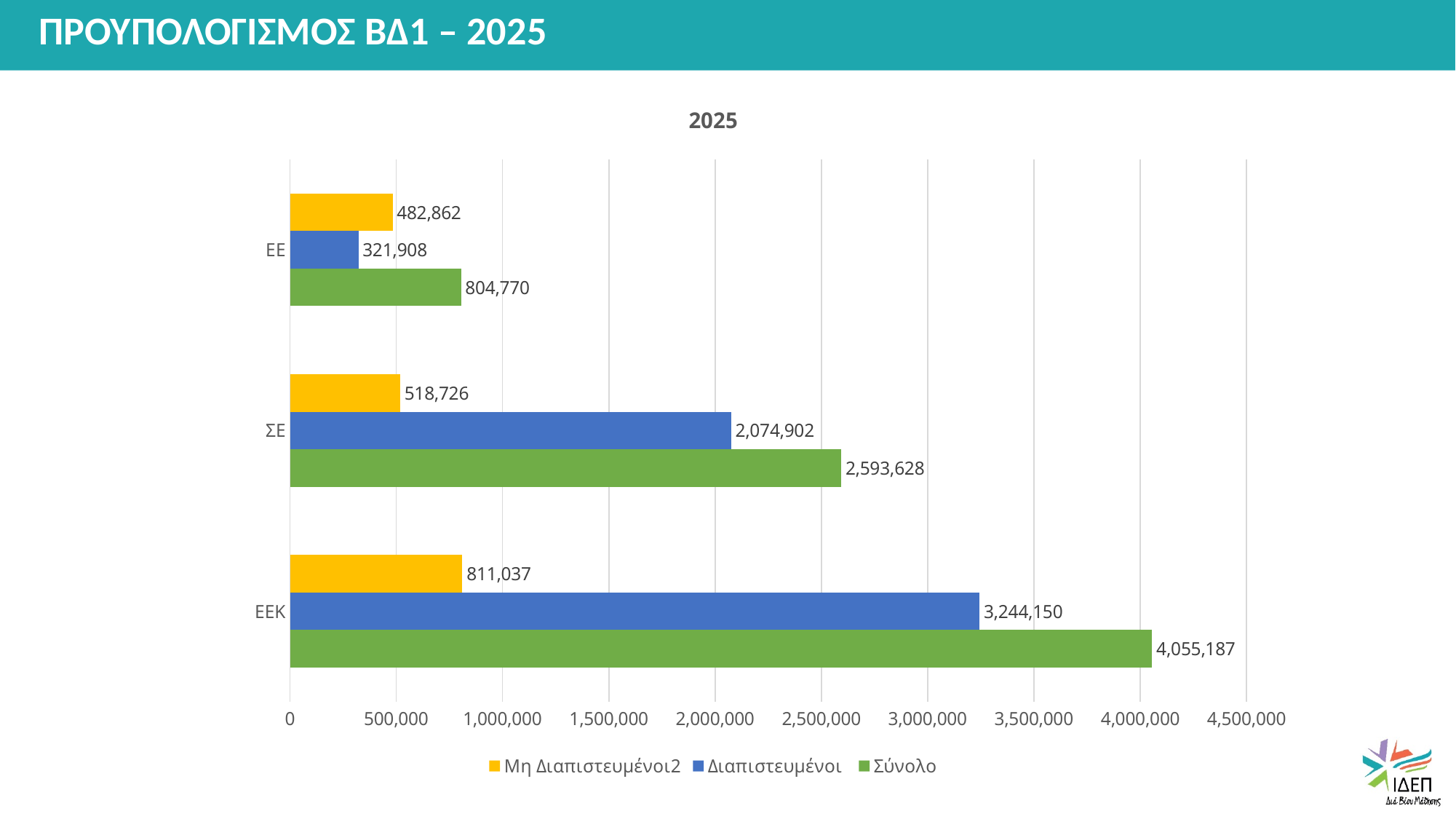
What is the title of the chart? 2025 What is the Σύνολο value for ΕΕΚ? 4,055,187 What type of chart is shown on the slide? bar chart Which category has the lowest Διαπιστευμένοι value? ΕΕ Which is larger for ΕΕ: the Μη Διαπιστευμένοι2 value or the Διαπιστευμένοι value? Μη Διαπιστευμένοι2 Which category has the highest Σύνολο value? ΕΕΚ What is the Μη Διαπιστευμένοι2 value for ΕΕ? 482,862 How many series does the legend list? 3 Is the Διαπιστευμένοι value for ΕΕΚ greater or less than 3,000,000? greater What is the difference between the Σύνολο values for ΕΕΚ and ΣΕ? 1,461,559 What is the Διαπιστευμένοι value for ΣΕ? 2,074,902 How many categories are shown on the y axis? 3